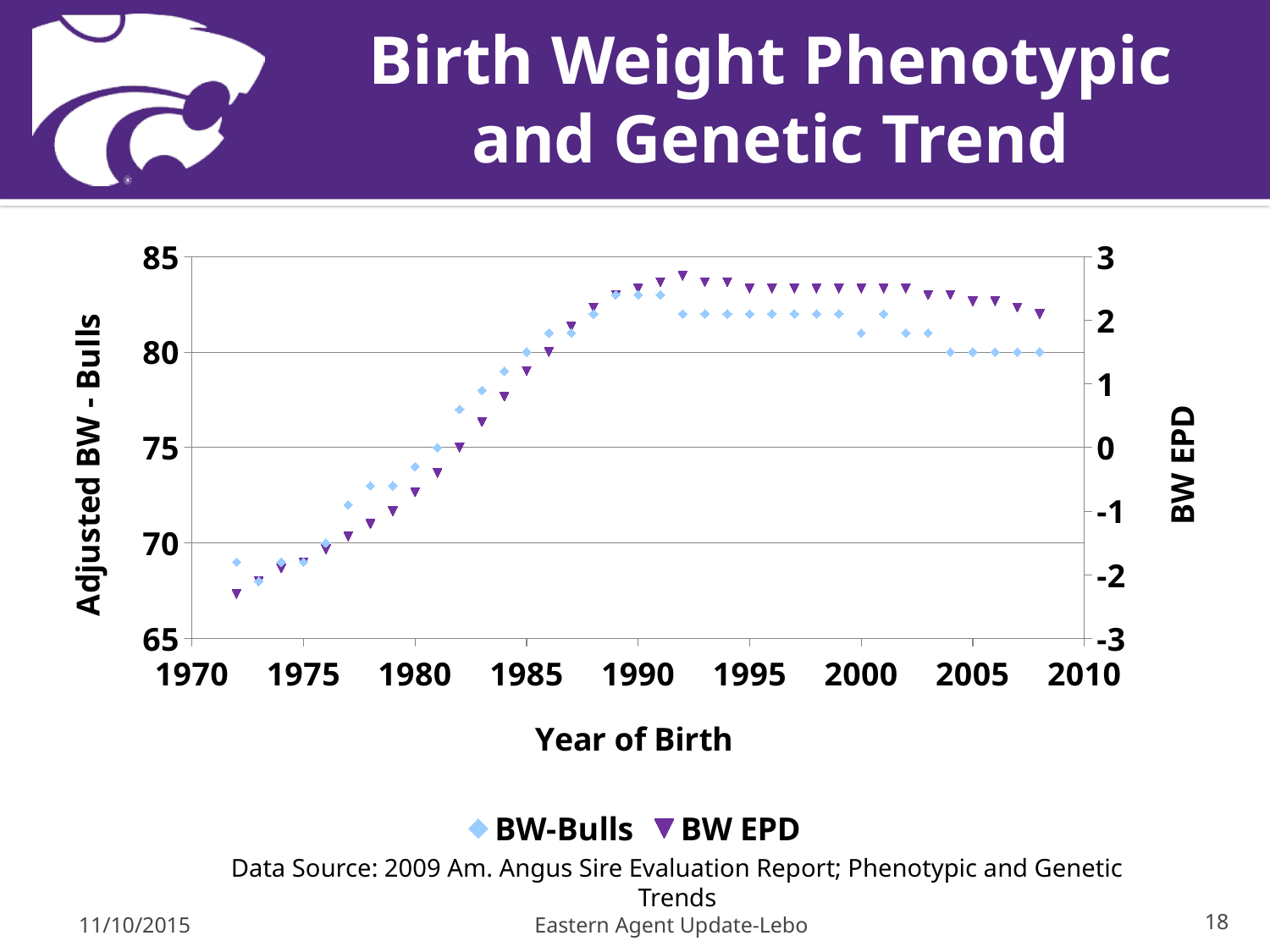
Is the BW EPD value for 1972 greater or less than -2? less Is the BW-Bulls value for 1972 greater or less than 70? less What kind of chart is shown on the slide? Scatter chart How many series does the chart legend list? 2 Is the BW-Bulls value for 1992 greater or less than 80? greater What is the title of the left vertical axis? Adjusted BW - Bulls Does the BW EPD series rise or fall between 1972 and 1990? Rise In which year of birth does the BW EPD series reach its highest value? 1992 Which series has the lower value in 1972 relative to its own axis, BW-Bulls or BW EPD, in terms of position on the chart? BW EPD What is the title of the horizontal axis? Year of Birth